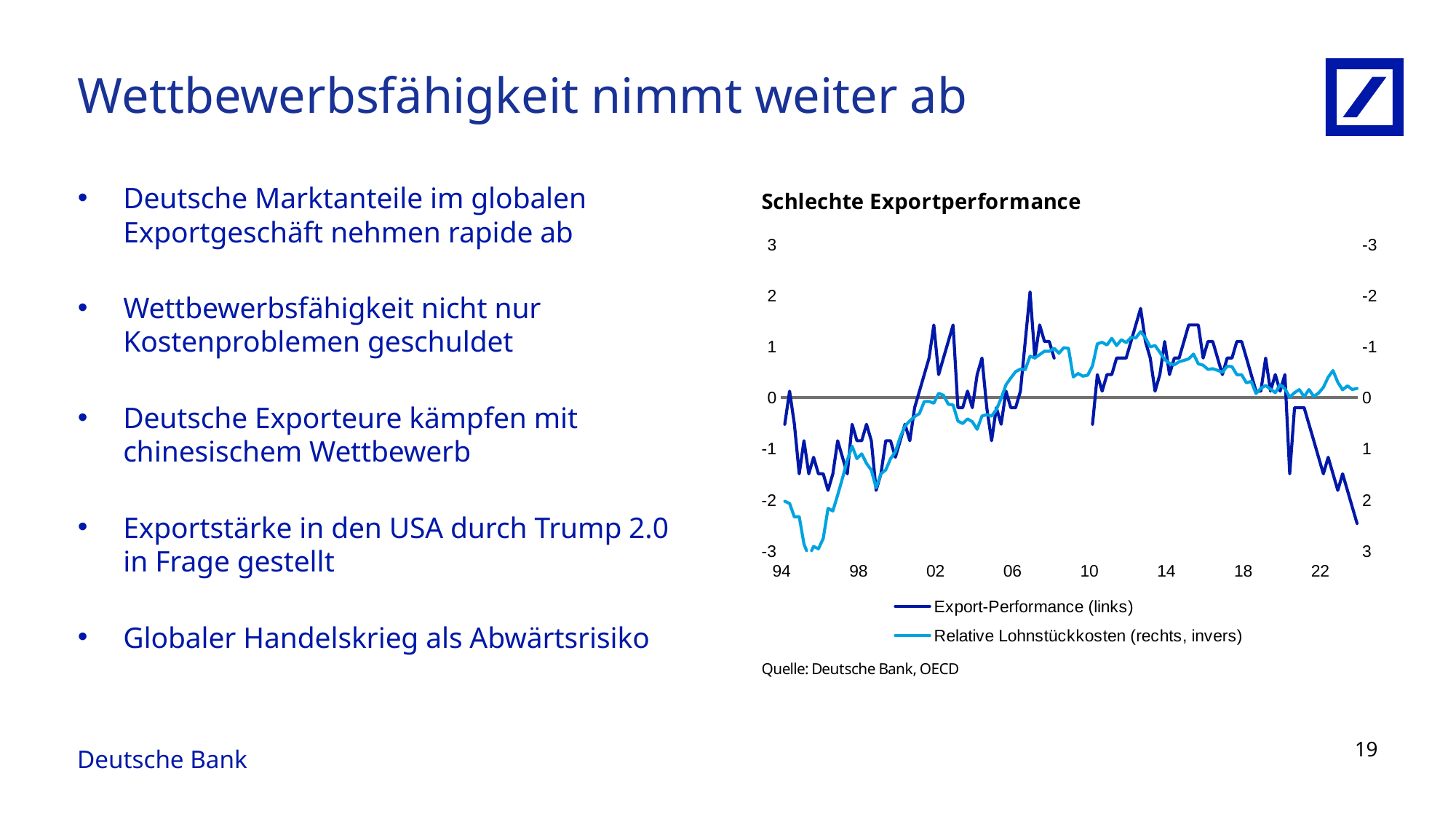
Is the highest Export-Performance value, reached around 2007, greater or less than 1 on the left axis? greater Does the Export-Performance series rise or fall between 98 and 02? Rise Does the Export-Performance series rise or fall between 18 and 22? Fall Is the Export-Performance value at the end of the series (after 22) greater or less than -2 on the left axis? less Which series in the chart is plotted against the right, inverted axis? Relative Lohnstückkosten (rechts, invers) What is the highest value shown on the left axis of the chart? 3 How many year labels are shown on the x axis of the chart? 8 What kind of chart is shown on the slide? Line chart How many series does the legend of the chart list? 2 What is the lowest value shown on the left axis of the chart? -3 What is the title of the chart? Schlechte Exportperformance Is the Export-Performance value at 94 greater or less than 0 on the left axis? less